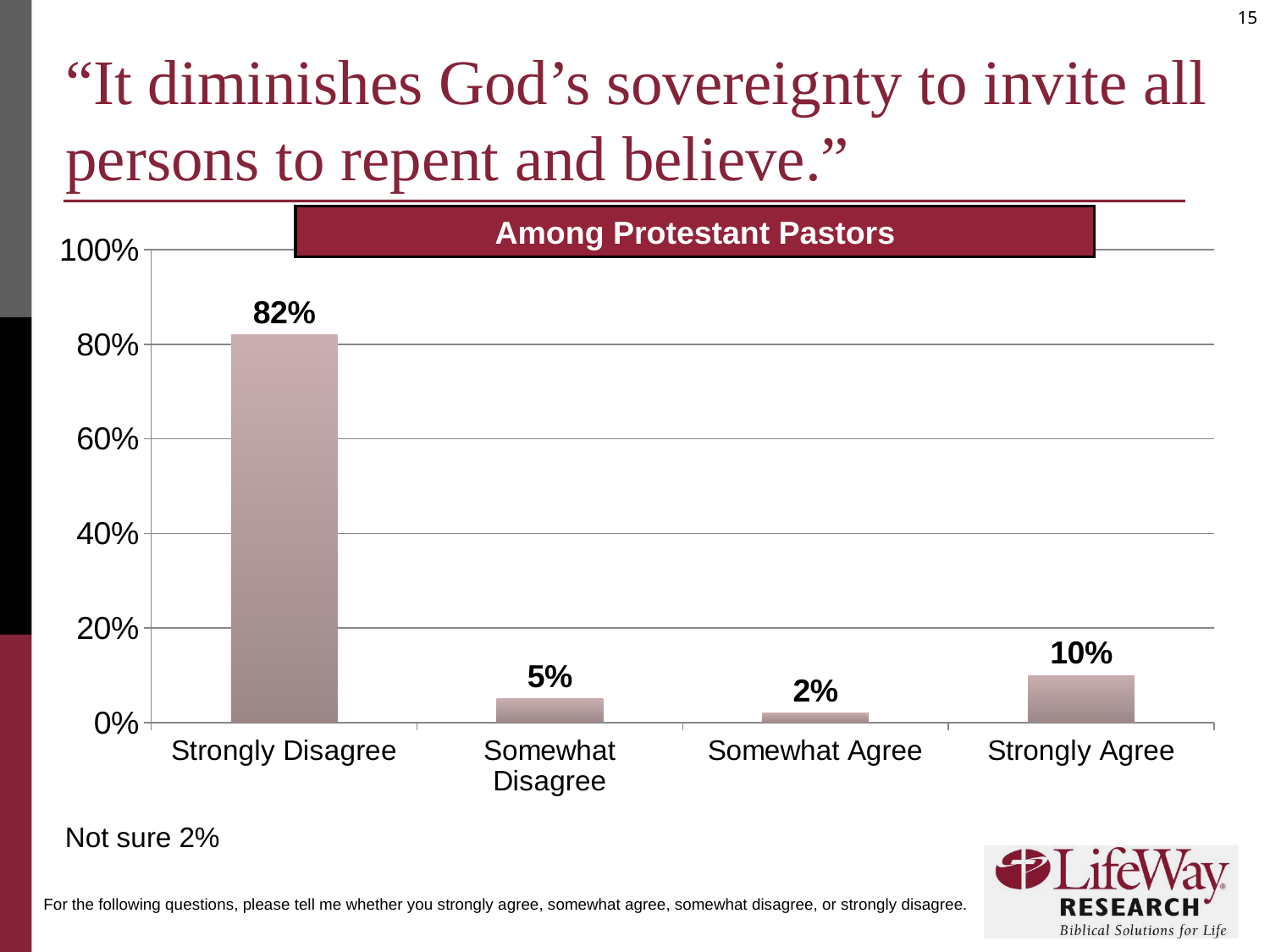
What percentage of Protestant pastors somewhat disagree? 5% What percentage of Protestant pastors strongly agree? 10% What percentage of Protestant pastors somewhat agree? 2% What percentage of pastors answered Not sure, according to the note below the chart? 2% What percentage of Protestant pastors strongly disagree? 82% What kind of chart is shown on the slide? Bar chart What is the difference between the Strongly Disagree and Strongly Agree values? 72% Is the value for Strongly Disagree greater or less than 80%? greater Which is larger, the value for Strongly Agree or the value for Somewhat Disagree? Strongly Agree Which response category has the lowest value? Somewhat Agree How many response categories are shown on the x axis? 4 Which response category has the highest value? Strongly Disagree